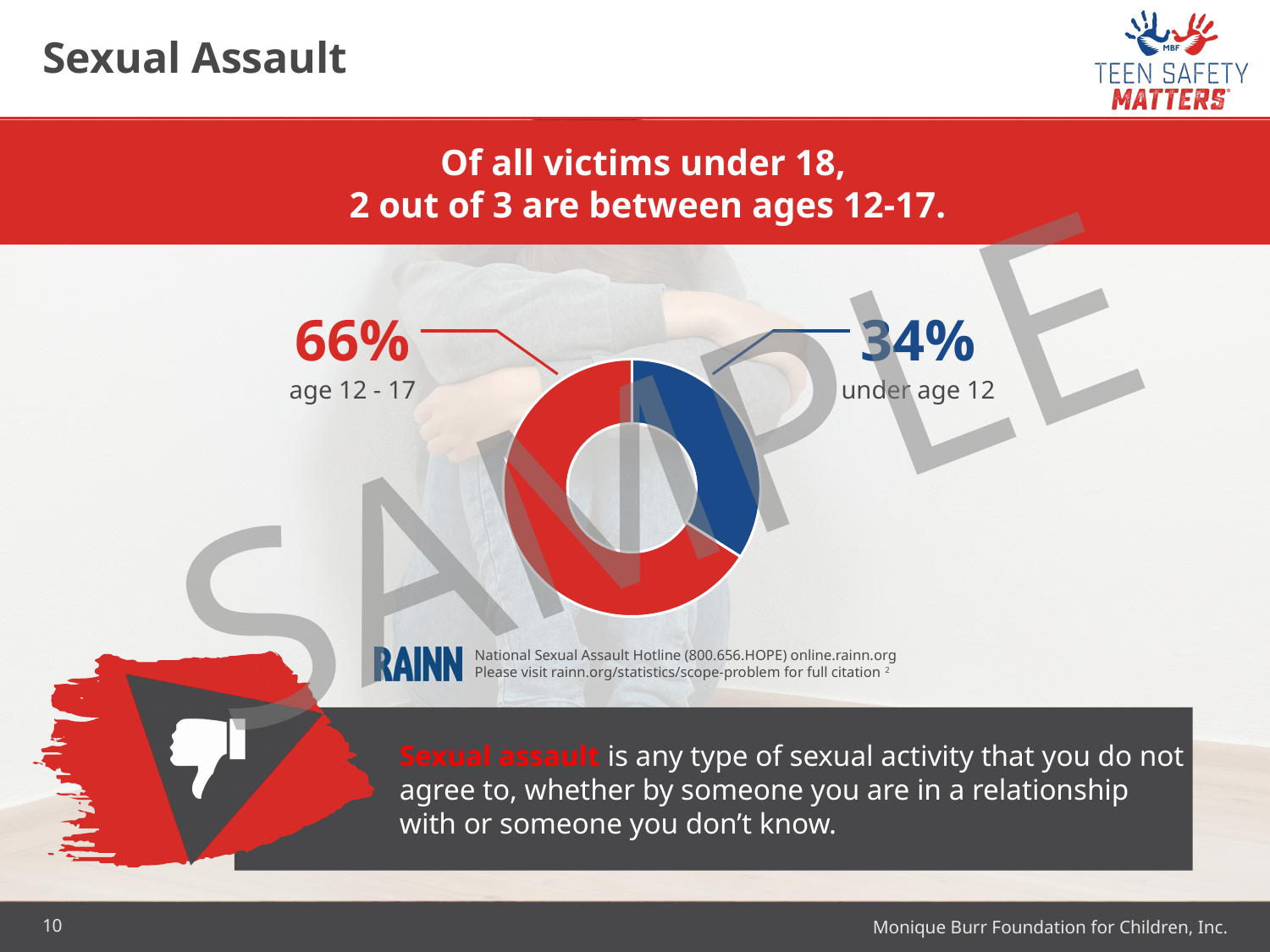
What is the difference in percentage points between the age 12 - 17 share and the under age 12 share? 32 Which category has the larger share of the chart? age 12 - 17 Is the share for age 12 - 17 larger or smaller than the share for under age 12? larger What colour is the slice for age 12 - 17? Red What kind of chart is shown on the slide? Doughnut (pie) chart What percentage of victims under 18 are under age 12? 34% How many categories does the chart show? 2 Which category has the smaller share of the chart? under age 12 What colour is the slice for under age 12? Blue What is the total of the two percentages shown on the chart? 100% What percentage of victims under 18 are age 12 - 17? 66%